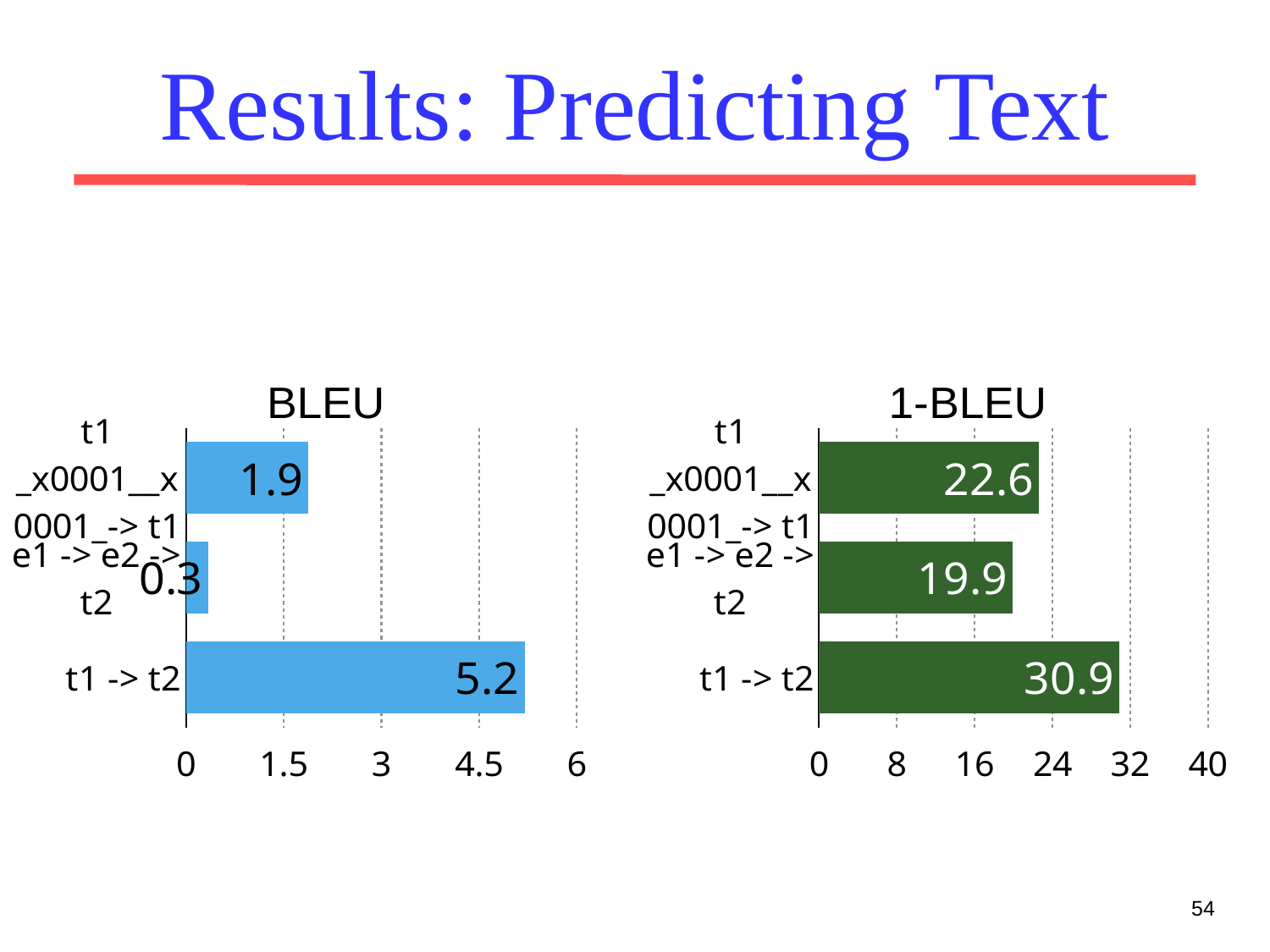
In the BLEU chart, what is the difference between the values for t1 -> t2 and e1 -> e2 -> t2? 4.9 In the BLEU chart, what is the value for e1 -> e2 -> t2? 0.3 In the 1-BLEU chart, what is the value for t1 -> t2? 30.9 In the 1-BLEU chart, what is the difference between the values for t1 -> t2 and e1 -> e2 -> t2? 11.0 What type of chart is the 1-BLEU chart? bar chart In the BLEU chart, what is the value for t1 -> t2? 5.2 In the BLEU chart, which category has the highest value? t1 -> t2 How many categories are shown in the BLEU chart? 3 In the 1-BLEU chart, which category has the lowest value? e1 -> e2 -> t2 In the 1-BLEU chart, is the value for t1 -> t2 greater or less than 24? greater In the BLEU chart, which category has the lowest value? e1 -> e2 -> t2 In the 1-BLEU chart, what is the value for e1 -> e2 -> t2? 19.9